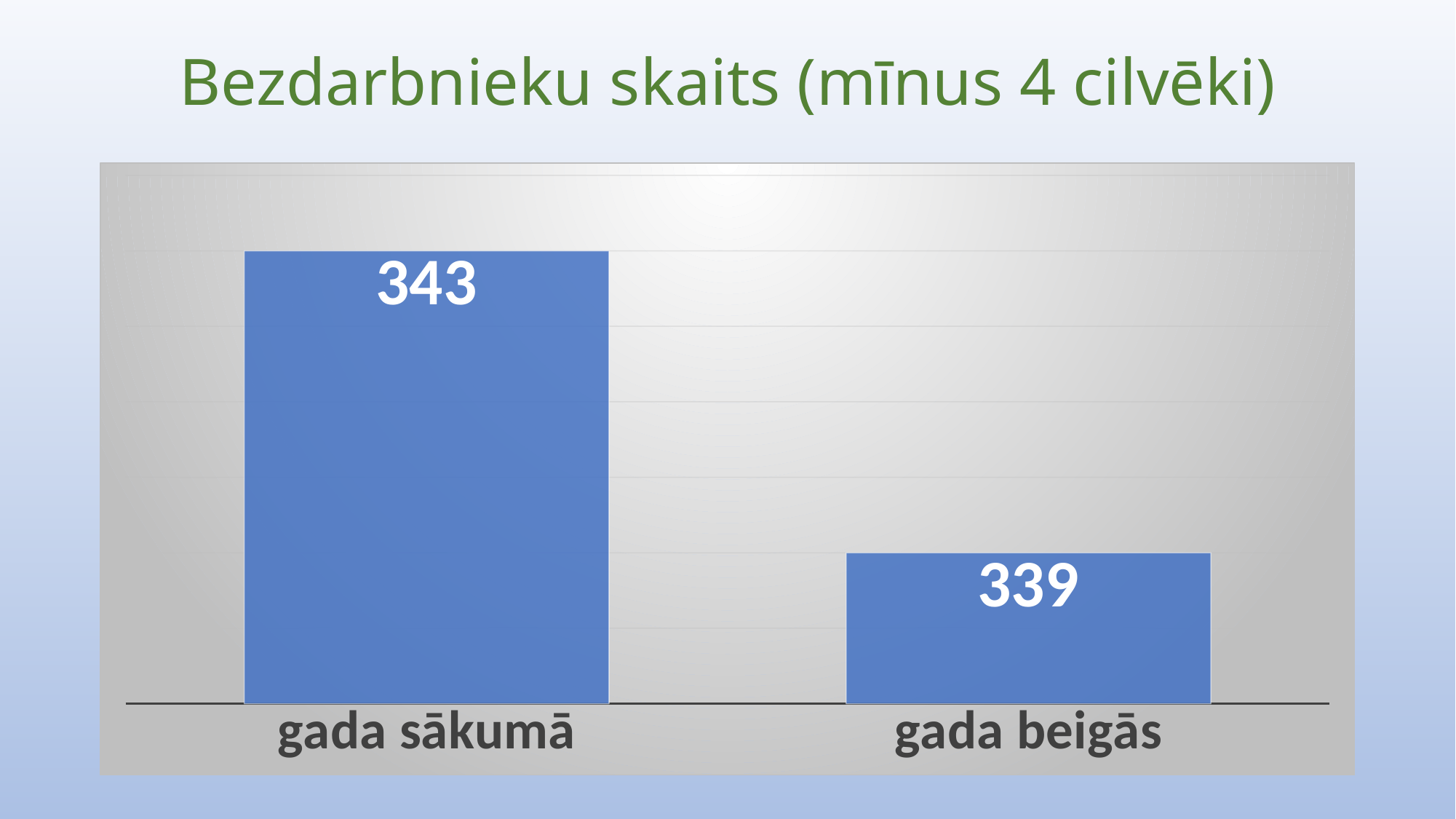
What colour are the bars in the chart? blue What is the difference between the values for "gada sākumā" and "gada beigās"? 4 Which category has the lowest value? gada beigās What is the value for "gada beigās"? 339 What is the title of the slide? Bezdarbnieku skaits (mīnus 4 cilvēki) How many categories are shown in the chart? 2 What kind of chart is shown on the slide? bar chart Do the values rise or fall from "gada sākumā" to "gada beigās"? fall Which is larger, the value for "gada sākumā" or "gada beigās"? gada sākumā What is the value for "gada sākumā"? 343 Which category has the highest value? gada sākumā